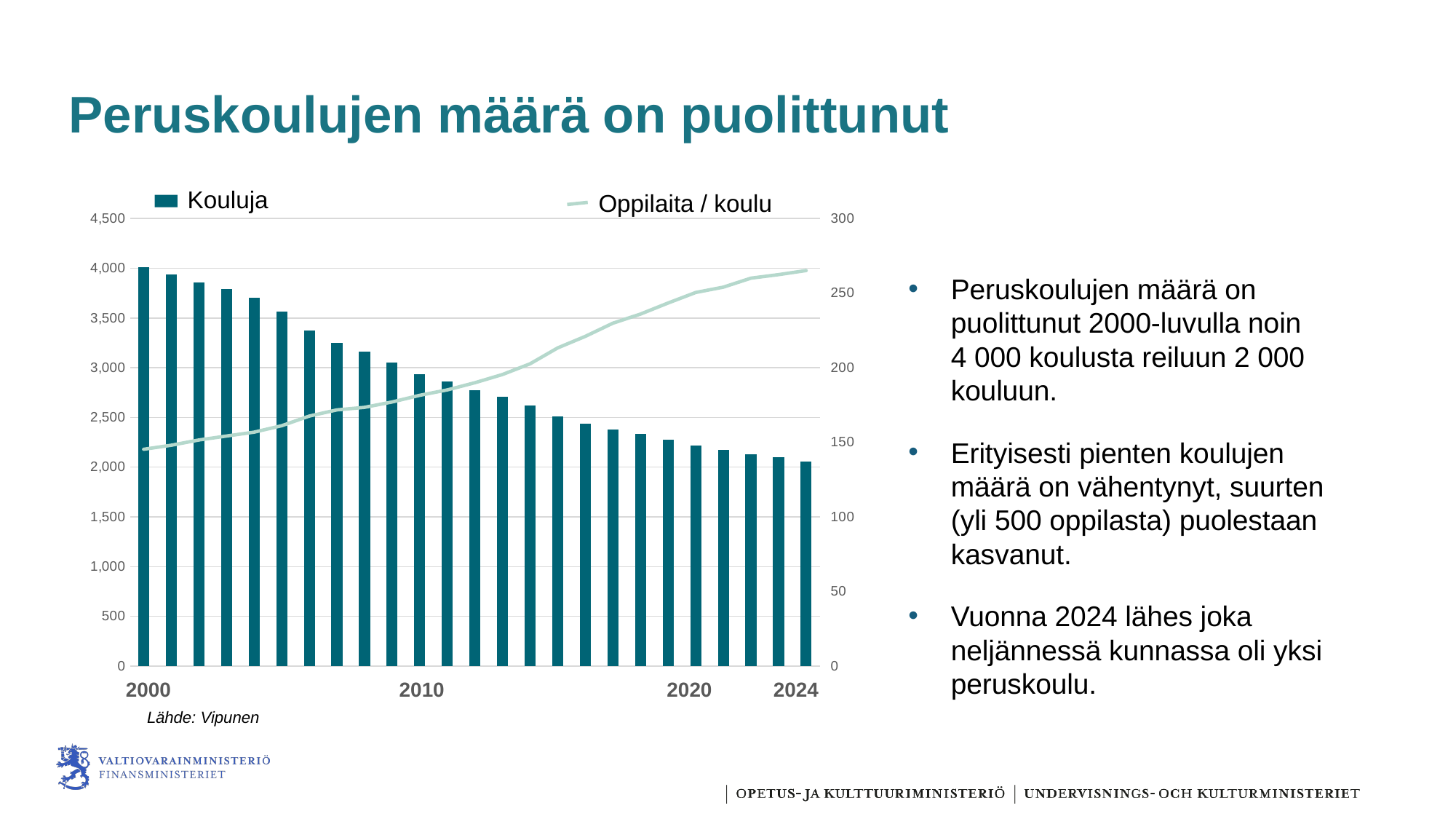
Is the Kouluja value for 2024 greater or less than 2,500? less Which year has the lowest Kouluja bar? 2024 How many series does the chart legend list? 2 Which is larger, the Kouluja value for 2000 or for 2024? 2000 Does the Oppilaita / koulu line rise or fall from 2000 to 2024? Rise Is the Kouluja value for 2000 greater or less than 3,500? greater Do the Kouluja bars rise or fall from 2000 to 2024? Fall What is the title of the slide above the chart? Peruskoulujen määrä on puolittunut Which year has the highest Kouluja bar? 2000 Is the Oppilaita / koulu value for 2024 greater or less than 250? greater What kind of chart is shown on the slide? A combined bar and line chart What are the two series named in the chart legend? Kouluja and Oppilaita / koulu